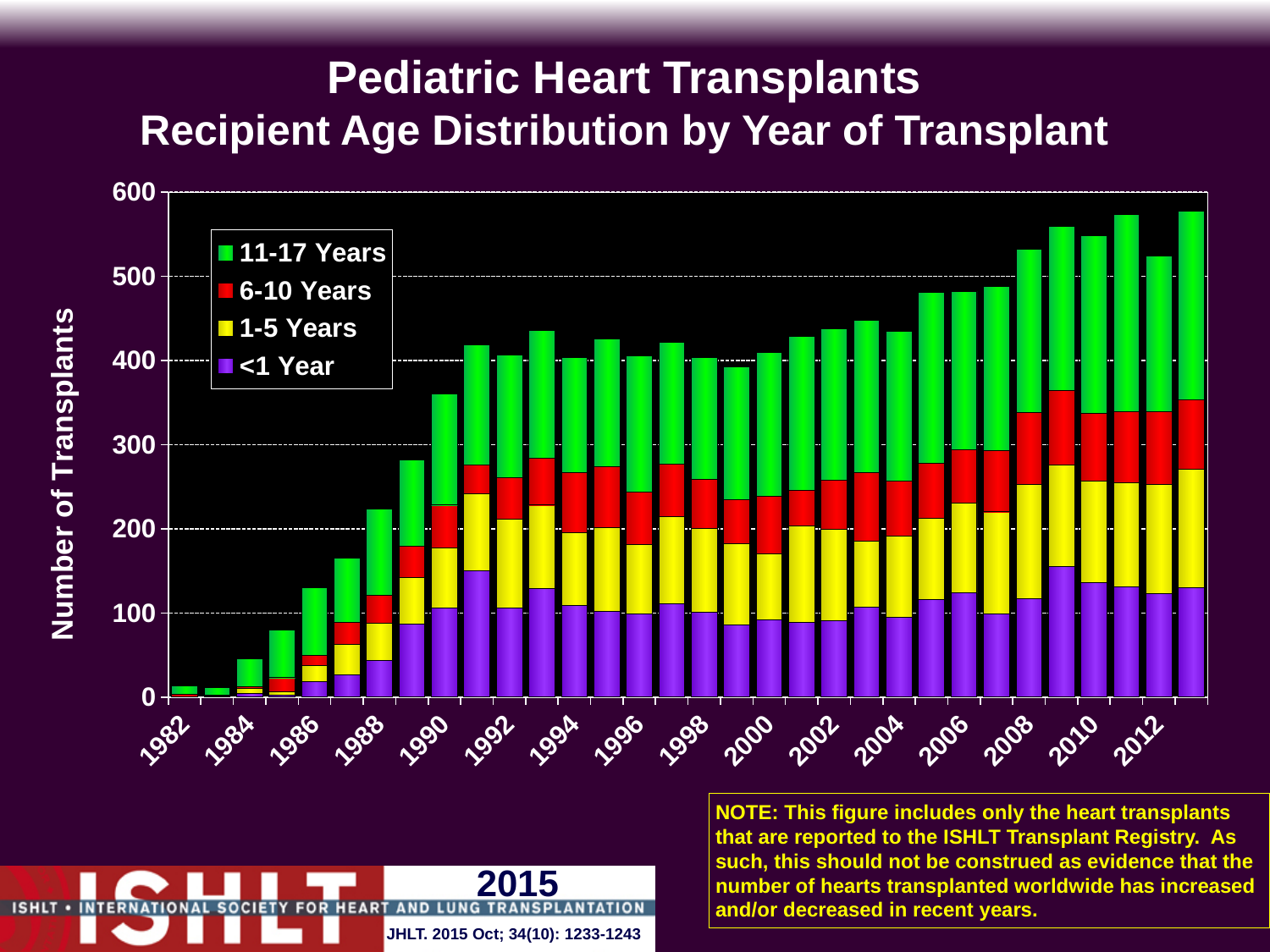
Do the total bar heights rise or fall from 1982 to 1990? rise What kind of chart is shown on the slide? stacked bar chart Which colour represents the <1 Year age group in the legend? purple How many series does the legend list? 4 Which year has the larger total number of transplants, 1988 or 1989? 1989 Is the total number of transplants for 2008 greater or less than 500? greater Is the total number of transplants for 1982 greater or less than 100? less How many years are labeled on the x axis? 16 What is the label of the y axis? Number of Transplants Is the total number of transplants for 1990 greater or less than 300? greater Which year has the larger total number of transplants, 1990 or 2000? 2000